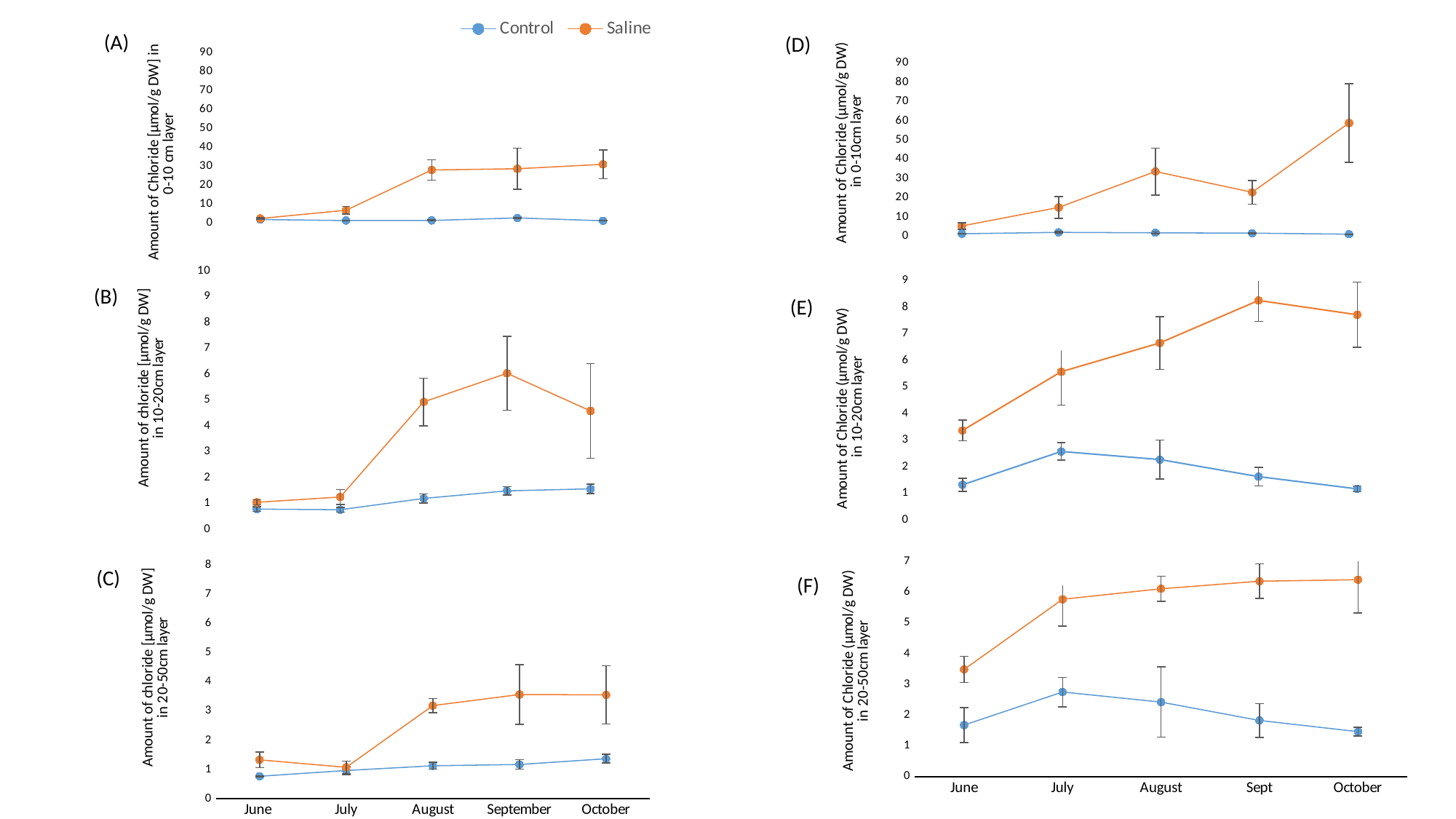
In chart (F), in which month is the Saline value lowest? June How many series does the legend list? 2 In chart (D), in which month is the Saline value highest? October In chart (B), in which month is the Saline value highest? September In chart (E), in which month is the Control value highest? July In chart (D), is the Saline value for Sept greater or less than 30? less In chart (A), is the Saline value for June greater or less than 10? less What kind of chart is chart (A)? line chart In chart (E), which series has the larger value in October, Control or Saline? Saline In chart (C), is the Control value for June greater or less than 1? less How many months are plotted along the x axis of chart (F)? 5